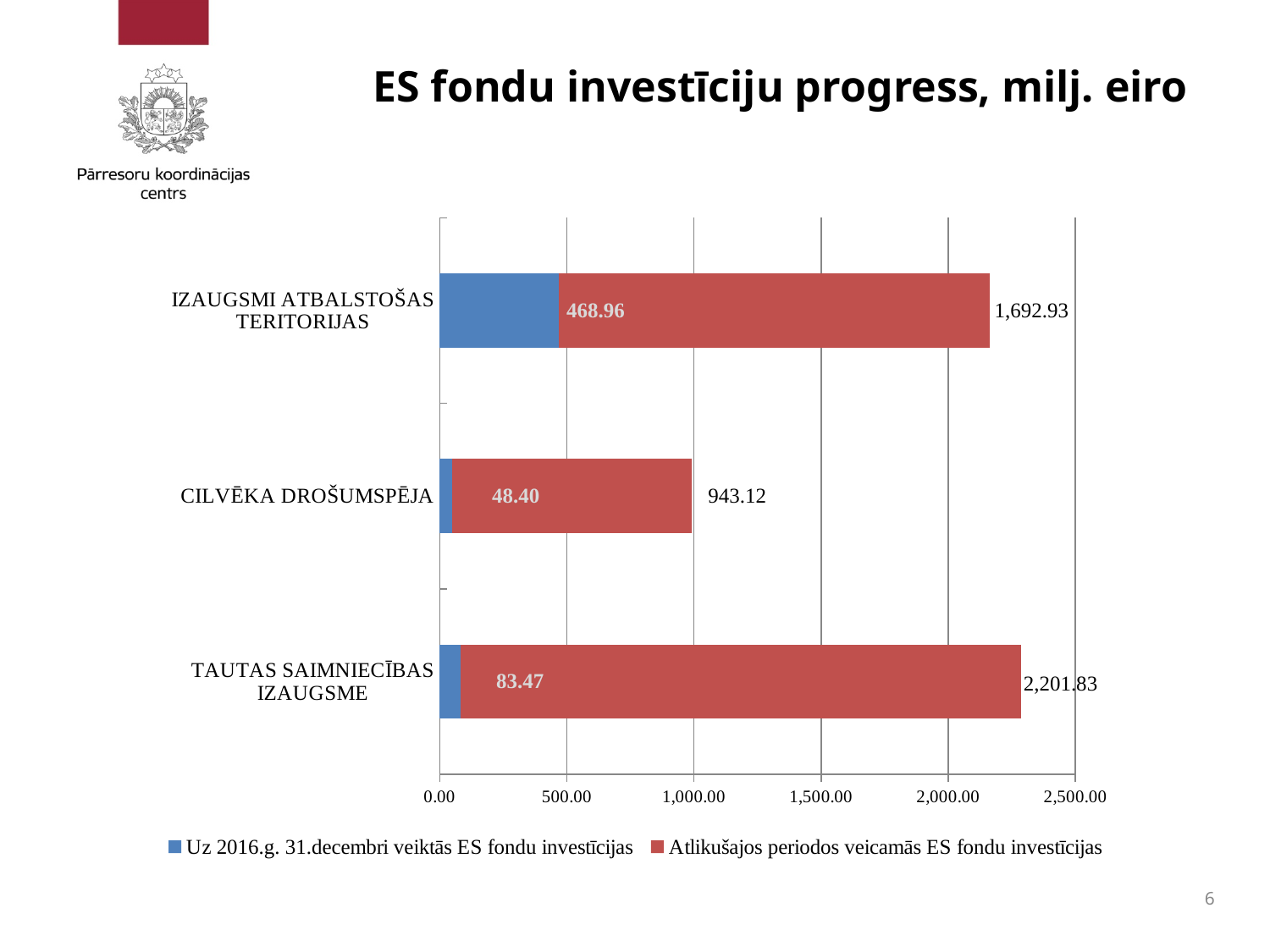
What is the total of the stacked bar for IZAUGSMI ATBALSTOŠAS TERITORIJAS? 2,161.89 What is the title of the chart? ES fondu investīciju progress, milj. eiro How many categories are shown on the chart? 3 Which category has the highest value for 'Atlikušajos periodos veicamās ES fondu investīcijas'? TAUTAS SAIMNIECĪBAS IZAUGSME What is the value of 'Atlikušajos periodos veicamās ES fondu investīcijas' for CILVĒKA DROŠUMSPĒJA? 943.12 What is the value of 'Atlikušajos periodos veicamās ES fondu investīcijas' for TAUTAS SAIMNIECĪBAS IZAUGSME? 2,201.83 What is the difference between the 'Atlikušajos periodos veicamās ES fondu investīcijas' values for TAUTAS SAIMNIECĪBAS IZAUGSME and CILVĒKA DROŠUMSPĒJA? 1,258.71 Which is larger: the 'Uz 2016.g. 31.decembri veiktās ES fondu investīcijas' value for TAUTAS SAIMNIECĪBAS IZAUGSME or for CILVĒKA DROŠUMSPĒJA? TAUTAS SAIMNIECĪBAS IZAUGSME What is the value of 'Uz 2016.g. 31.decembri veiktās ES fondu investīcijas' for IZAUGSMI ATBALSTOŠAS TERITORIJAS? 468.96 Which category has the lowest value for 'Uz 2016.g. 31.decembri veiktās ES fondu investīcijas'? CILVĒKA DROŠUMSPĒJA What type of chart is shown on the slide? bar chart How many series does the legend list? 2